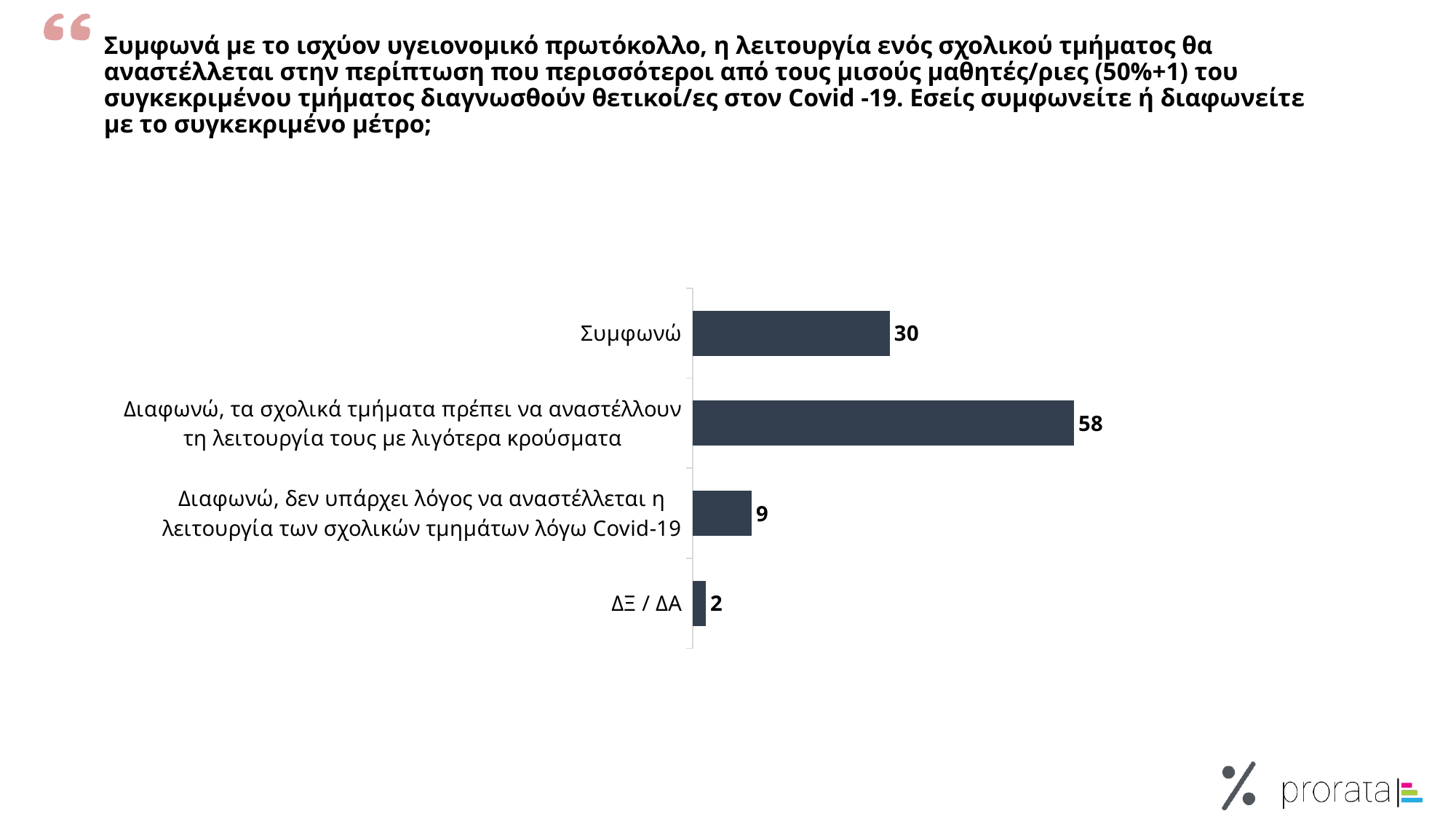
Which category has the lowest value? ΔΞ / ΔΑ Which category has the highest value? Διαφωνώ, τα σχολικά τμήματα πρέπει να αναστέλλουν τη λειτουργία τους με λιγότερα κρούσματα What is the difference between the value for Συμφωνώ and the value for "Διαφωνώ, δεν υπάρχει λόγος να αναστέλλεται η λειτουργία των σχολικών τμημάτων λόγω Covid-19"? 21 Which is larger: the value for Συμφωνώ or the value for ΔΞ / ΔΑ? Συμφωνώ What is the value for ΔΞ / ΔΑ? 2 What is the value for "Διαφωνώ, τα σχολικά τμήματα πρέπει να αναστέλλουν τη λειτουργία τους με λιγότερα κρούσματα"? 58 What colour are the bars in the chart? Dark grey How many categories are shown in the chart? 4 What is the value for Συμφωνώ? 30 What is the difference between the value for "Διαφωνώ, τα σχολικά τμήματα πρέπει να αναστέλλουν τη λειτουργία τους με λιγότερα κρούσματα" and the value for Συμφωνώ? 28 What is the value for "Διαφωνώ, δεν υπάρχει λόγος να αναστέλλεται η λειτουργία των σχολικών τμημάτων λόγω Covid-19"? 9 What kind of chart is shown on the slide? Bar chart